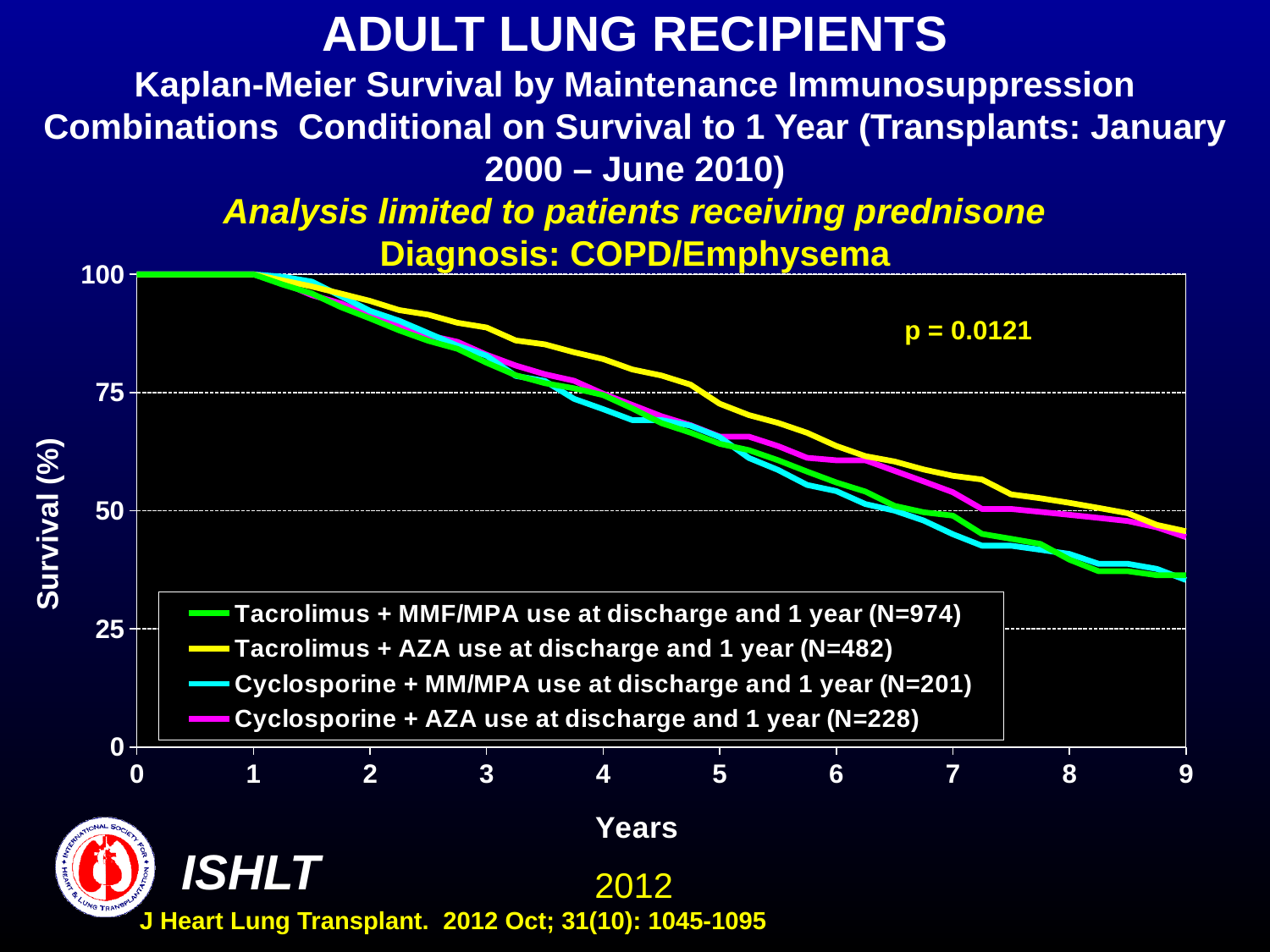
How many series does the legend list? 4 What kind of chart is shown on the slide? line chart What is the N for the Tacrolimus + AZA use at discharge and 1 year group in the legend? 482 Is the survival for Cyclosporine + MM/MPA use at discharge and 1 year at year 8 greater or less than 50? less Is the survival for Tacrolimus + MMF/MPA use at discharge and 1 year at year 9 greater or less than 50? less What p-value is printed on the chart? p = 0.0121 Is the survival for Tacrolimus + MMF/MPA use at discharge and 1 year at year 2 greater or less than 75? greater At year 6, which is higher: survival for Tacrolimus + AZA use at discharge and 1 year or for Cyclosporine + MM/MPA use at discharge and 1 year? Tacrolimus + AZA use at discharge and 1 year Which group has the highest survival at year 4? Tacrolimus + AZA use at discharge and 1 year Do the survival curves rise or fall as the years increase? fall